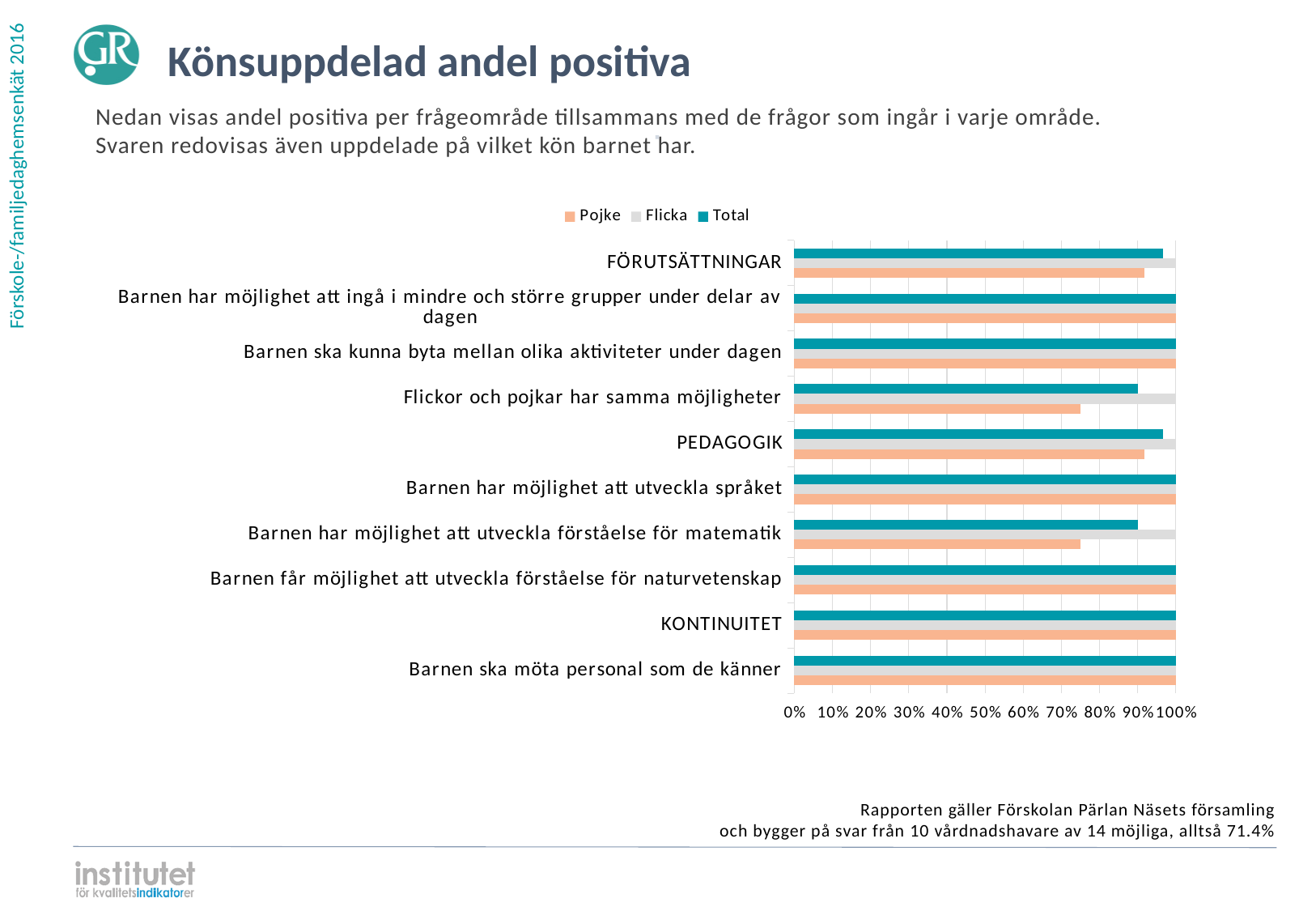
What is the Pojke value for 'Barnen ska möta personal som de känner'? 100% How many categories are shown on the vertical axis of the chart? 10 Is the Pojke value for 'Barnen har möjlighet att utveckla förståelse för matematik' greater or less than 80%? less Is the Total value for FÖRUTSÄTTNINGAR greater or less than 90%? greater What kind of chart is shown on the slide? bar chart Is the Pojke value for PEDAGOGIK greater or less than 80%? greater For 'Flickor och pojkar har samma möjligheter', which is larger, the Pojke value or the Flicka value? Flicka How many series does the legend list? 3 Which series is shown in orange in the legend? Pojke What is the Flicka value for 'Flickor och pojkar har samma möjligheter'? 100%